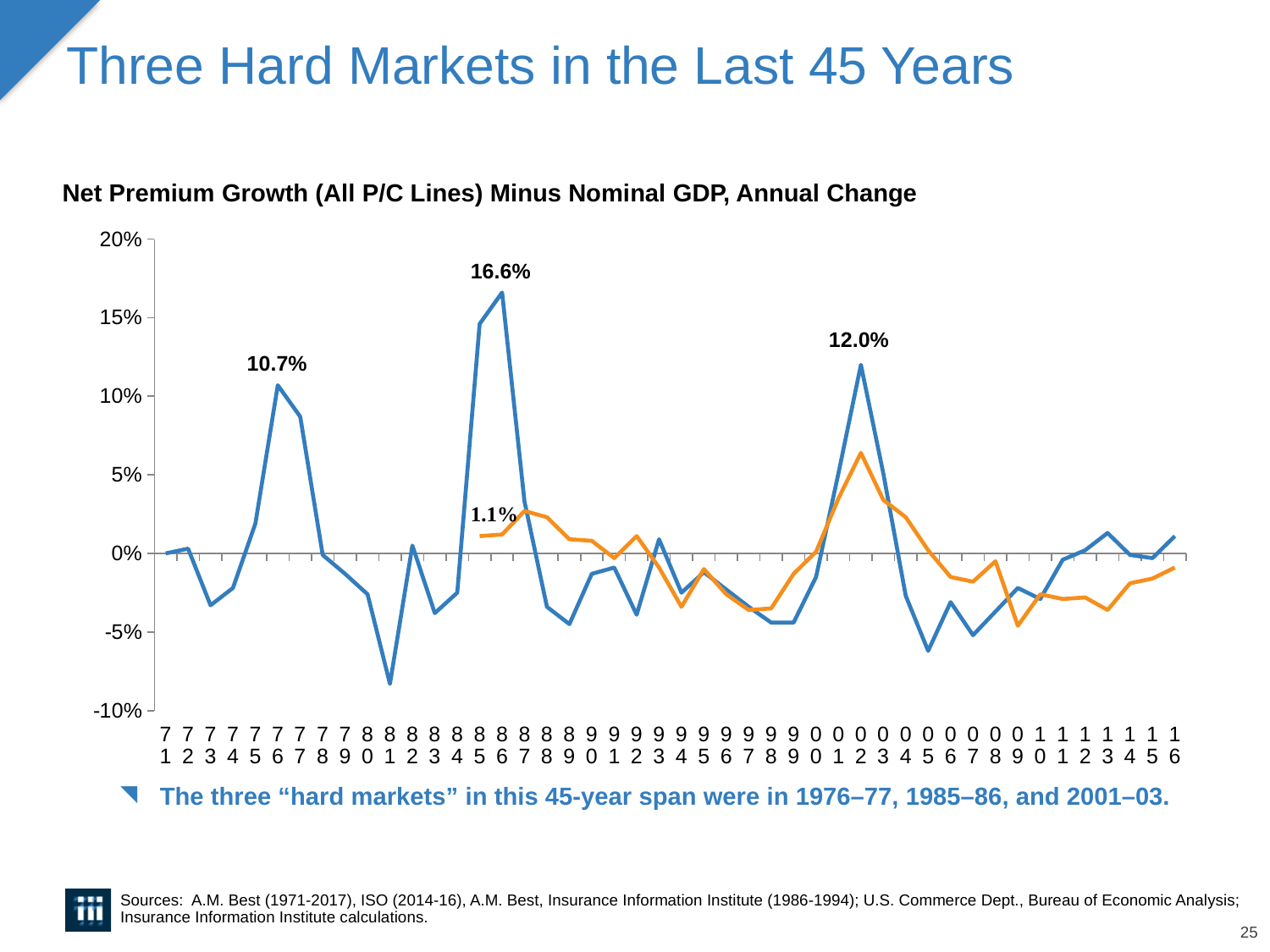
In which year does the blue line reach its labeled peak of 16.6%? 86 What is the labeled value shown on the orange line near 1985? 1.1% What kind of chart is shown on the slide? line chart What is the labeled value of the blue line's peak in 2002? 12.0% How many lines are plotted on the chart? 2 Which labeled peak is larger, the 1976 peak or the 2002 peak? 2002 peak (12.0%) What is the highest labeled peak value on the blue line? 16.6% Is the value of the blue line in 1981 greater or less than -5%? less Is the value of the blue line in 1985 greater or less than 10%? greater What is the labeled value of the blue line's peak in 1976? 10.7% What is the difference between the labeled 1986 peak (16.6%) and the labeled 2002 peak (12.0%)? 4.6 percentage points What is the title of the chart? Net Premium Growth (All P/C Lines) Minus Nominal GDP, Annual Change